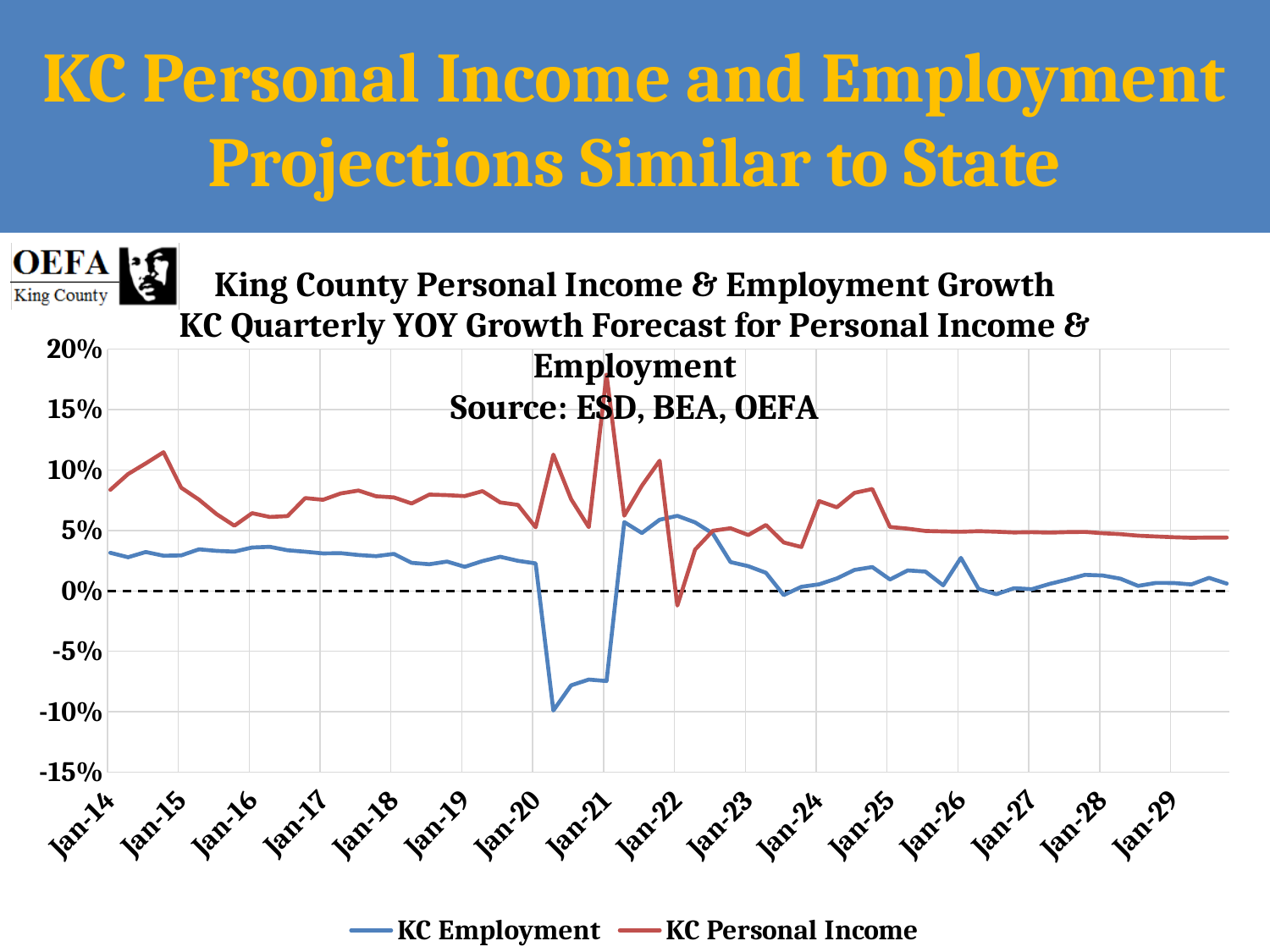
Is the value for KC Personal Income at Jan-17 greater or less than 5%? greater Is the value for KC Employment at Jan-14 greater or less than 5%? less How many year labels are shown on the x axis? 16 What kind of chart is shown on the slide? Line chart What are the two series named in the legend? KC Employment and KC Personal Income Is the lowest value of KC Employment greater or less than -5%? less In which year does KC Employment reach its lowest value? 2020 At Jan-14, which series has the higher value, KC Employment or KC Personal Income? KC Personal Income In which year does KC Personal Income reach its highest value? 2021 What source is cited for the chart? ESD, BEA, OEFA How many series does the legend list? 2